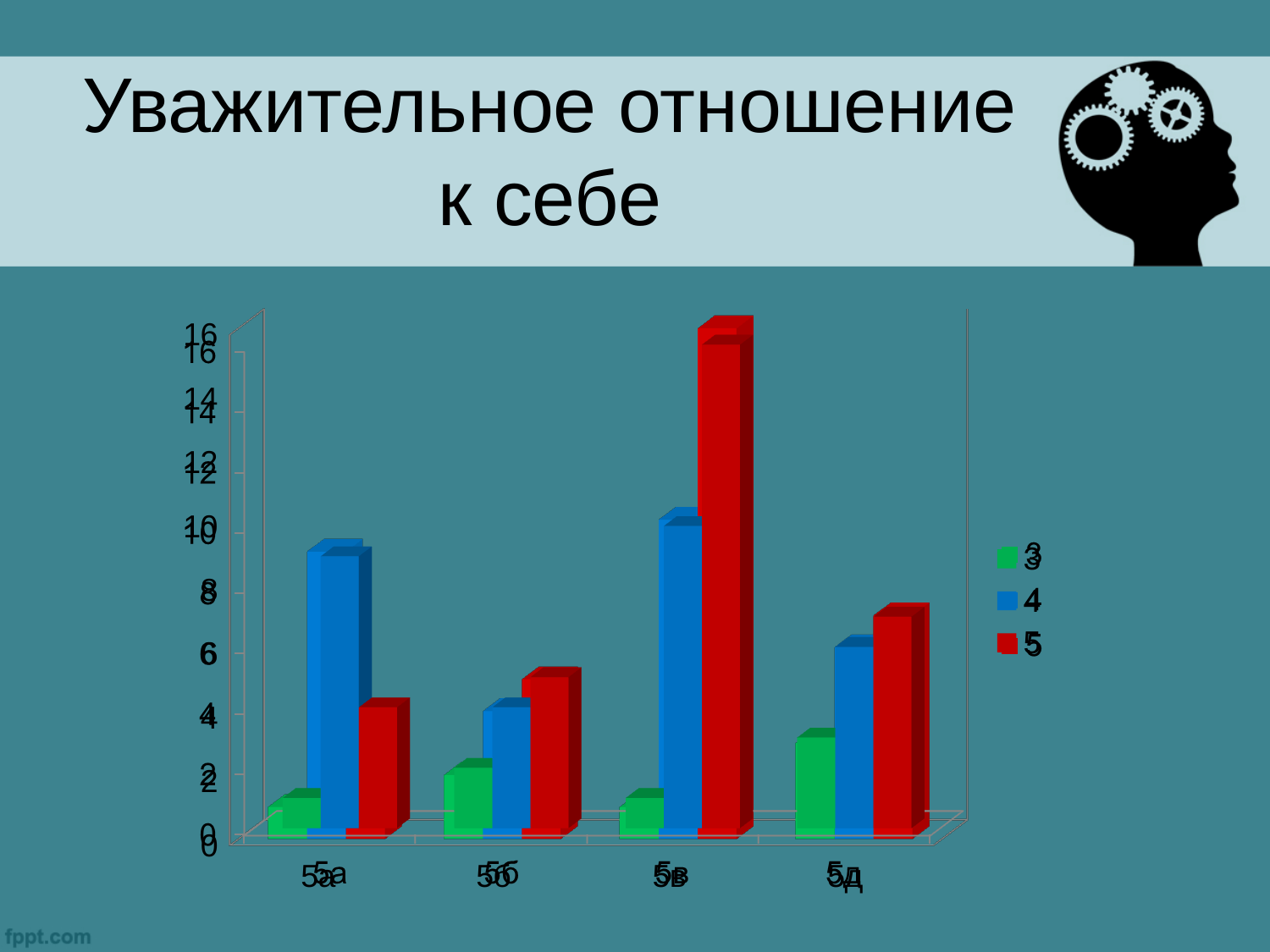
In category 5в, which series has the larger value, series 4 or series 5? series 5 How many series does the chart legend list? 3 Which category has the highest value for series 5? 5в Which category has the lowest value for series 4? 5б In category 5а, which series has the larger value, series 4 or series 5? series 4 Is the value for series 4 in category 5а greater or less than 6? greater Is the value for series 5 in category 5в greater or less than 14? greater Which category has the highest value for series 3? 5д What is the title of the slide containing the chart? Уважительное отношение к себе What kind of chart is shown on the slide? bar chart How many categories are shown on the x axis of the chart? 4 Is the value for series 5 in category 5а greater or less than 6? less